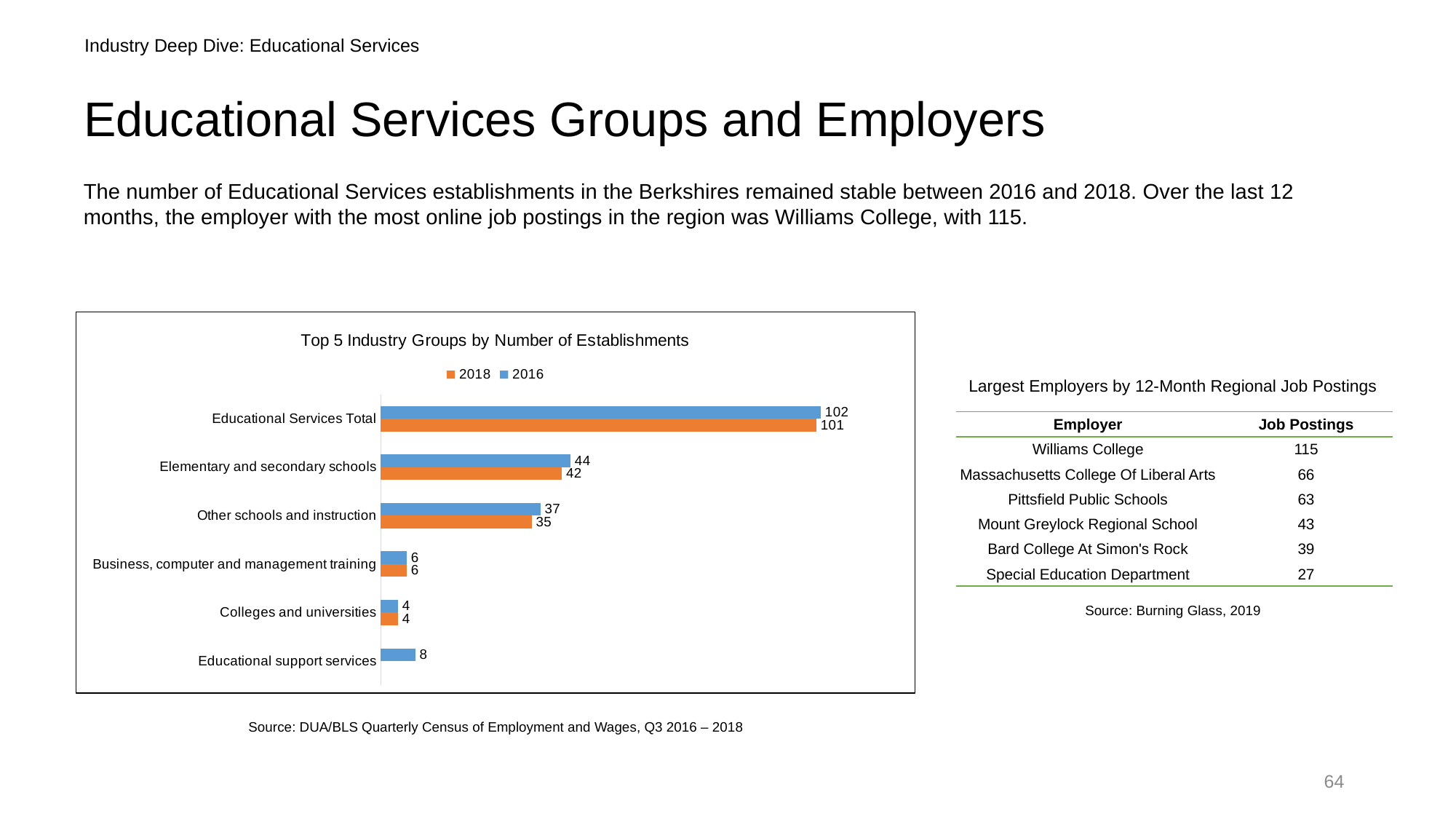
What is the 2016 value for Educational support services in the Top 5 Industry Groups chart? 8 How many series does the legend of the Top 5 Industry Groups chart list? 2 What is the 2016 value for Educational Services Total in the Top 5 Industry Groups chart? 102 How many categories are shown on the Top 5 Industry Groups by Number of Establishments chart? 6 In the Top 5 Industry Groups chart, is the 2016 value for Other schools and instruction larger than the 2016 value for Business, computer and management training? Yes What type of chart is used for Top 5 Industry Groups by Number of Establishments? Bar chart What is the 2018 value for Elementary and secondary schools in the Top 5 Industry Groups chart? 42 Which category has the lowest 2018 value in the Top 5 Industry Groups chart? Colleges and universities Which colour represents the 2018 series in the Top 5 Industry Groups chart? Orange Excluding the Educational Services Total, which category has the highest 2016 value in the Top 5 Industry Groups chart? Elementary and secondary schools What is the difference between the 2016 and 2018 values for Elementary and secondary schools in the Top 5 Industry Groups chart? 2 What is the 2018 value for Other schools and instruction in the Top 5 Industry Groups chart? 35